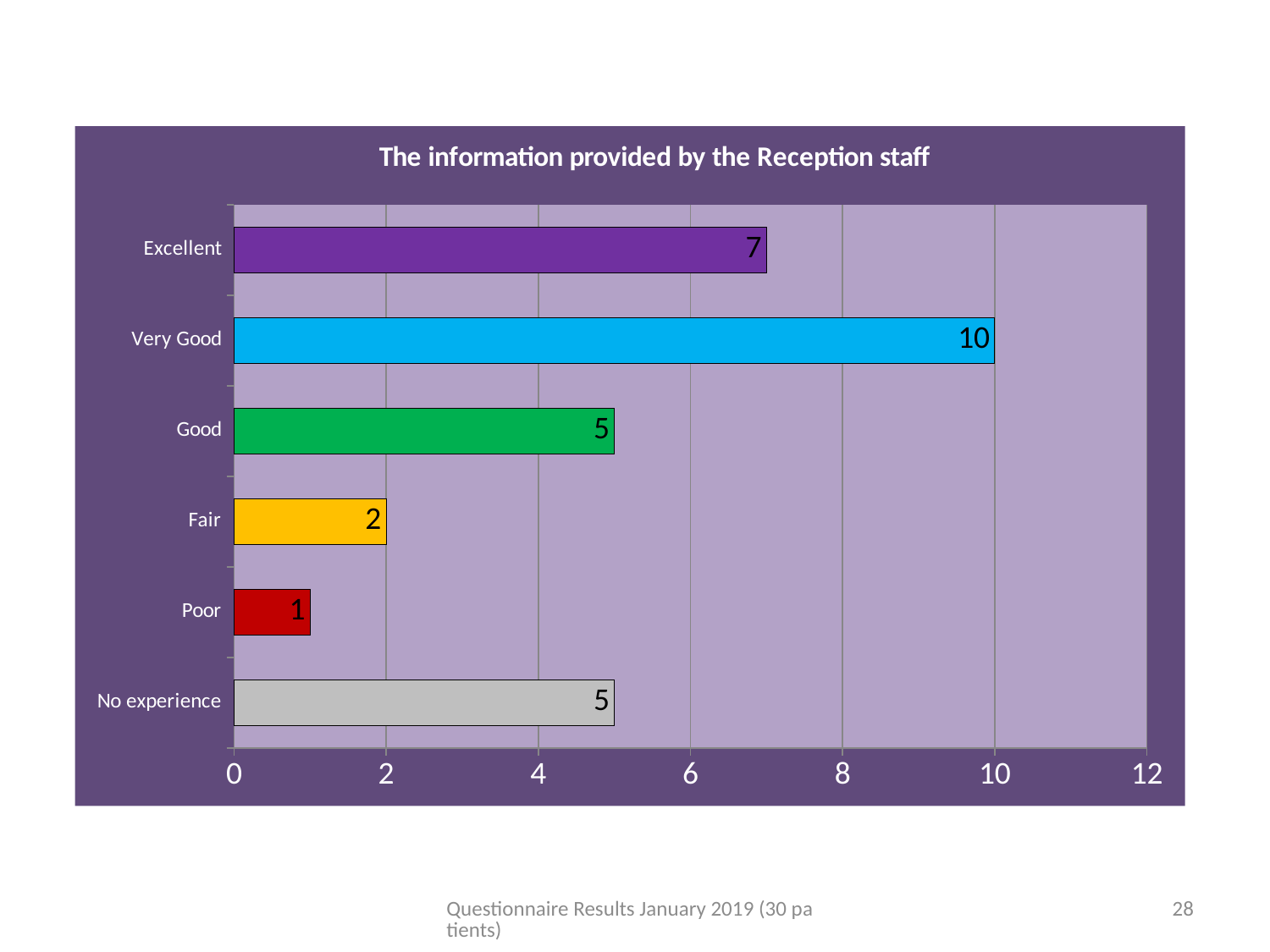
Which category has the lowest value? Poor What is the value for No experience? 5 How many categories are shown in the chart? 6 What is the value for Excellent? 7 Which is larger, the value for Good or the value for Fair? Good What kind of chart is shown on the slide? bar chart Which category has the highest value? Very Good What is the value for Very Good? 10 What is the title of the chart? The information provided by the Reception staff What is the value for Poor? 1 What is the difference between the values for Very Good and Excellent? 3 Is the value for Excellent greater or less than 6? greater